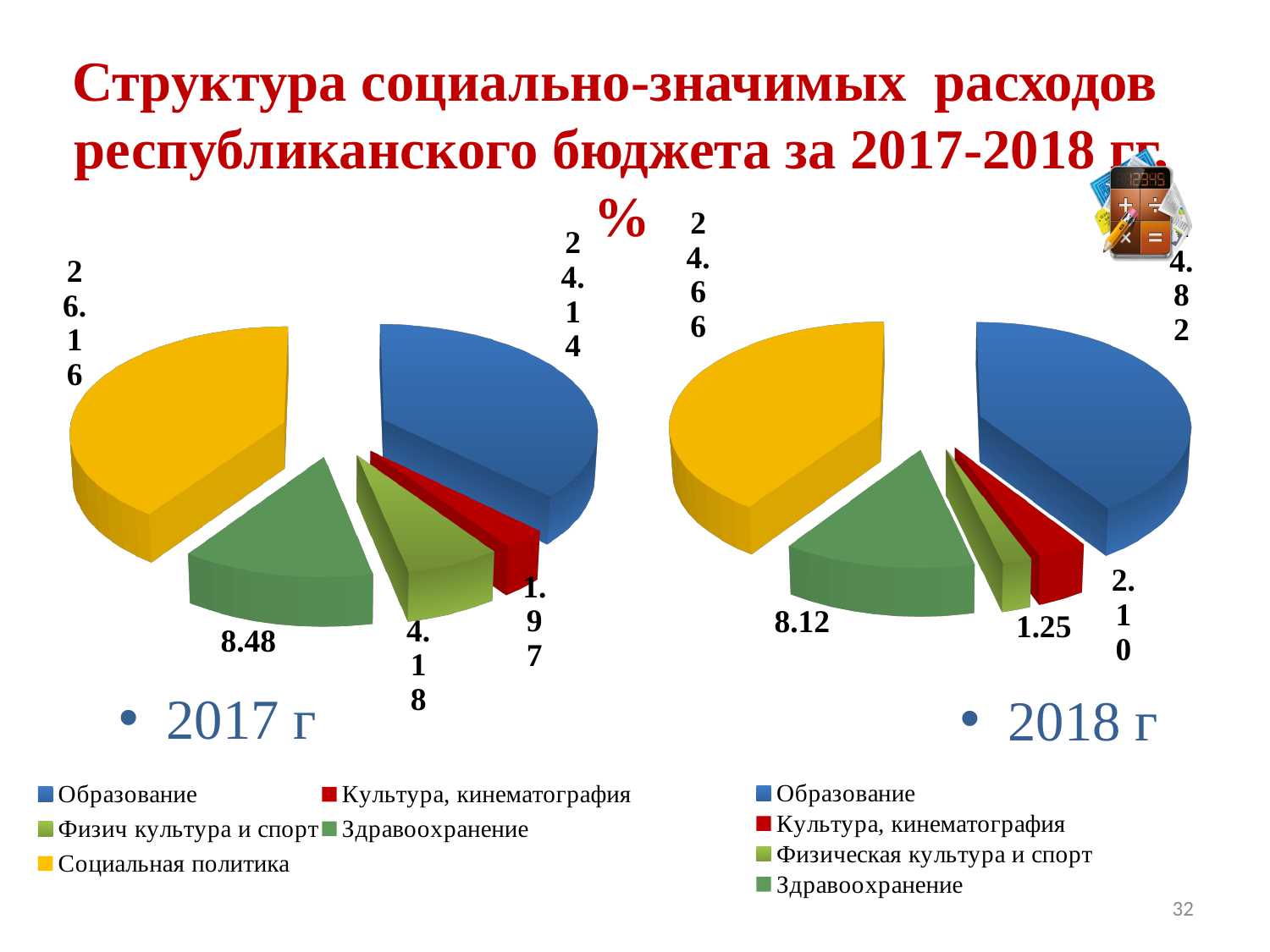
How many entries does the legend of the 2018 г pie chart list? 4 In the 2018 г pie chart, what is the value for Здравоохранение? 8.12 In the 2017 г pie chart, what is the value for Здравоохранение? 8.48 In the 2017 г pie chart, what is the value for Физич культура и спорт? 4.18 In the 2017 г pie chart, what is the value for Культура, кинематография? 1.97 In the 2018 г pie chart, what is the value for Культура, кинематография? 2.10 In the 2018 г pie chart, what is the value for Физическая культура и спорт? 1.25 In the 2017 г pie chart, which category has the largest slice? Социальная политика In the 2017 г pie chart, which category has the smallest slice? Культура, кинематография What kind of chart is used for the 2017 г data on the slide? pie chart In the 2017 г pie chart, what is the difference between the values for Здравоохранение and Физич культура и спорт? 4.30 In the 2018 г pie chart, which category has the smallest slice? Физическая культура и спорт